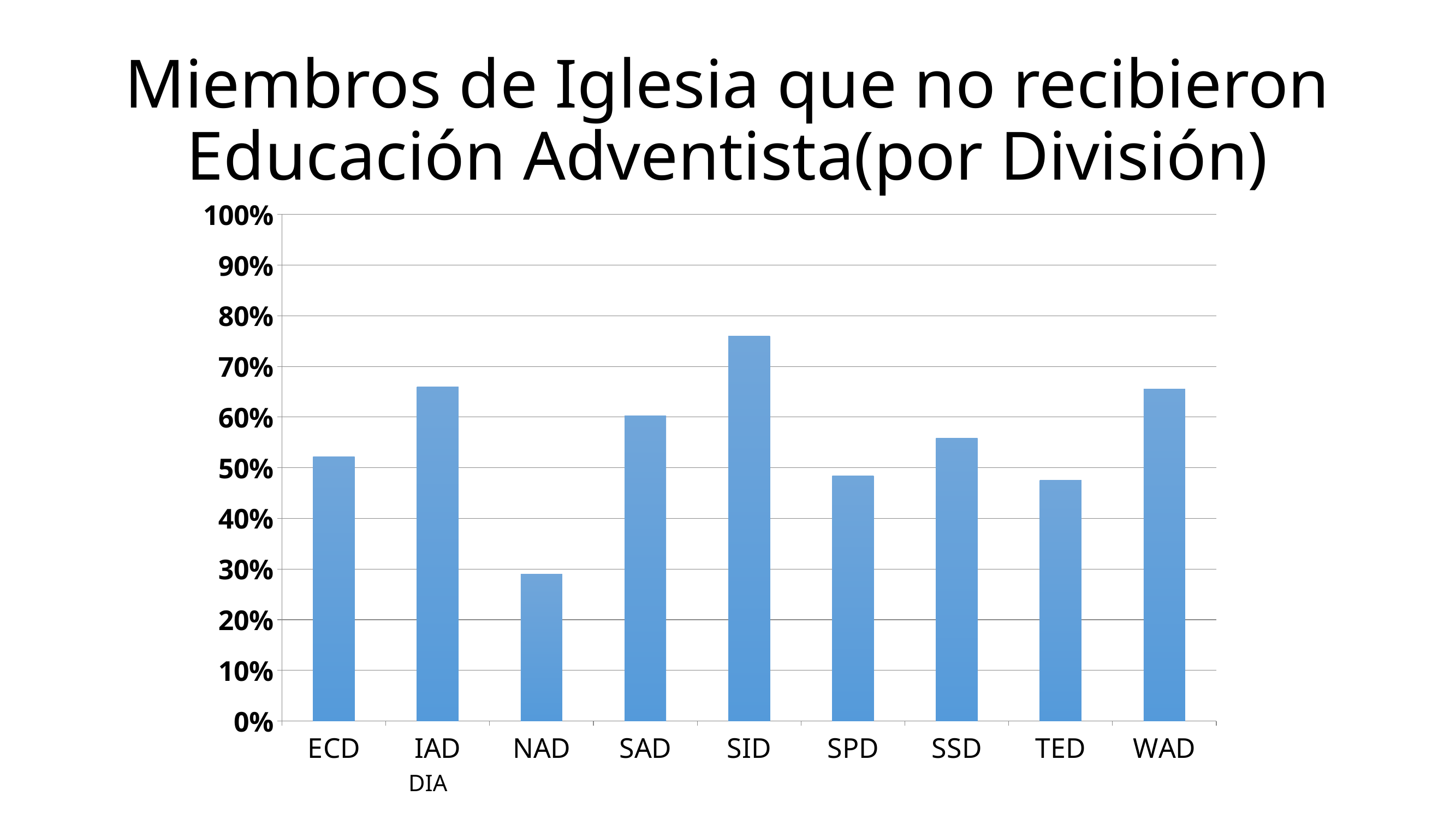
What kind of chart is shown on the slide? bar chart Which is larger, the value for SAD or the value for ECD? SAD Is the value for SSD greater or less than 50%? greater Is the value for SID greater or less than 70%? greater Is the value for TED greater or less than 50%? less How many divisions (categories) are shown on the x axis? 9 Which division has the lowest bar? NAD What is the title of the chart? Miembros de Iglesia que no recibieron Educación Adventista(por División) Which is larger, the value for SID or the value for IAD? SID Which division has the highest bar? SID